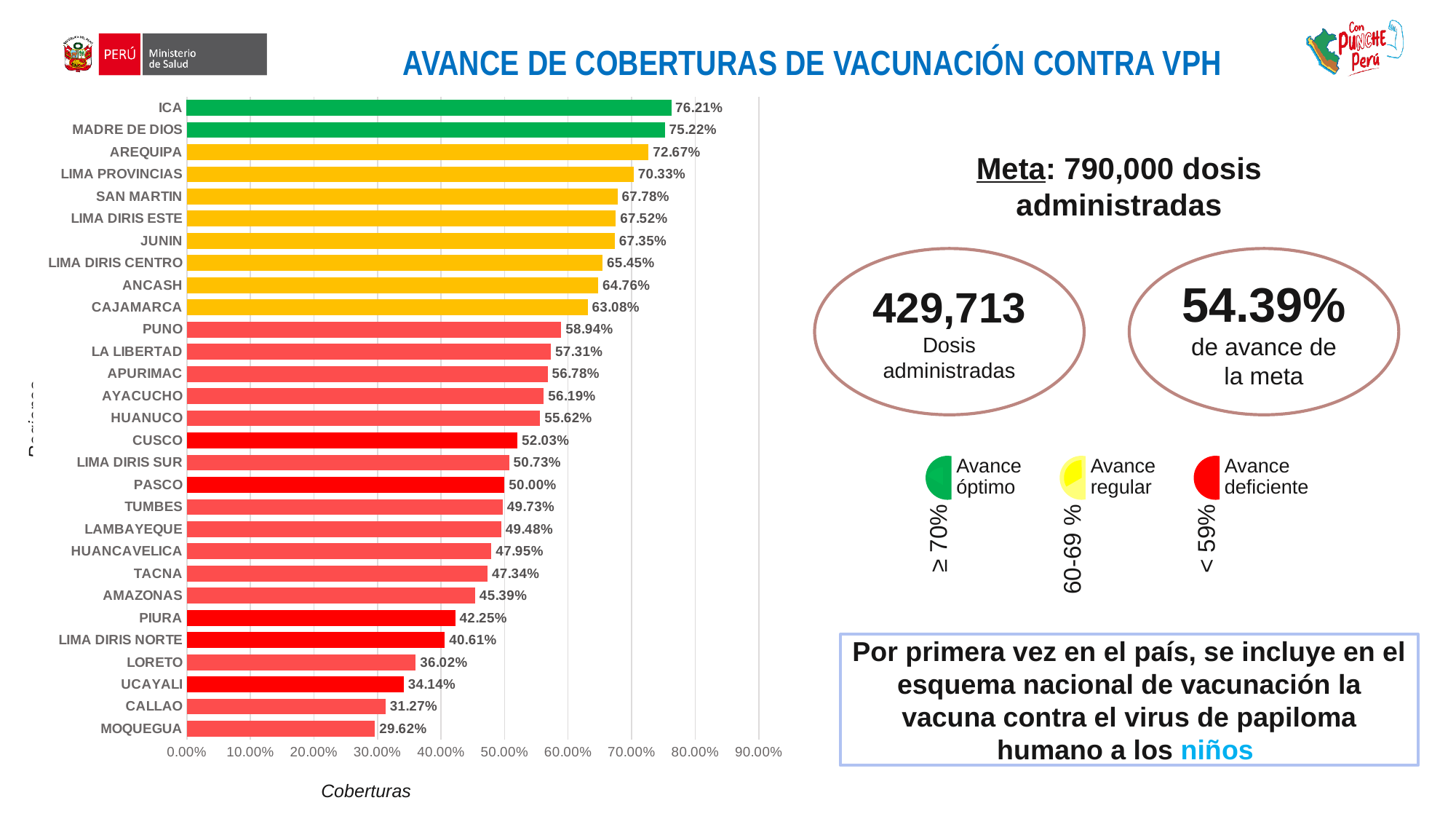
Which has a higher coverage, PUNO or TACNA? PUNO What is the label on the horizontal axis of the chart? Coberturas Which region has the highest coverage? ICA What is the difference between the coverage of AREQUIPA and CAJAMARCA? 9.59% Is the coverage for LORETO greater or less than 40.00%? less What is the coverage value for CUSCO? 52.03% What is the coverage value for LIMA DIRIS NORTE? 40.61% How many regions are shown in the bar chart? 29 Which region has the lowest coverage? MOQUEGUA What kind of chart is used to show the coverage by region? bar chart What is the difference between the coverage of ICA and MOQUEGUA? 46.59% What is the coverage value for AREQUIPA? 72.67%